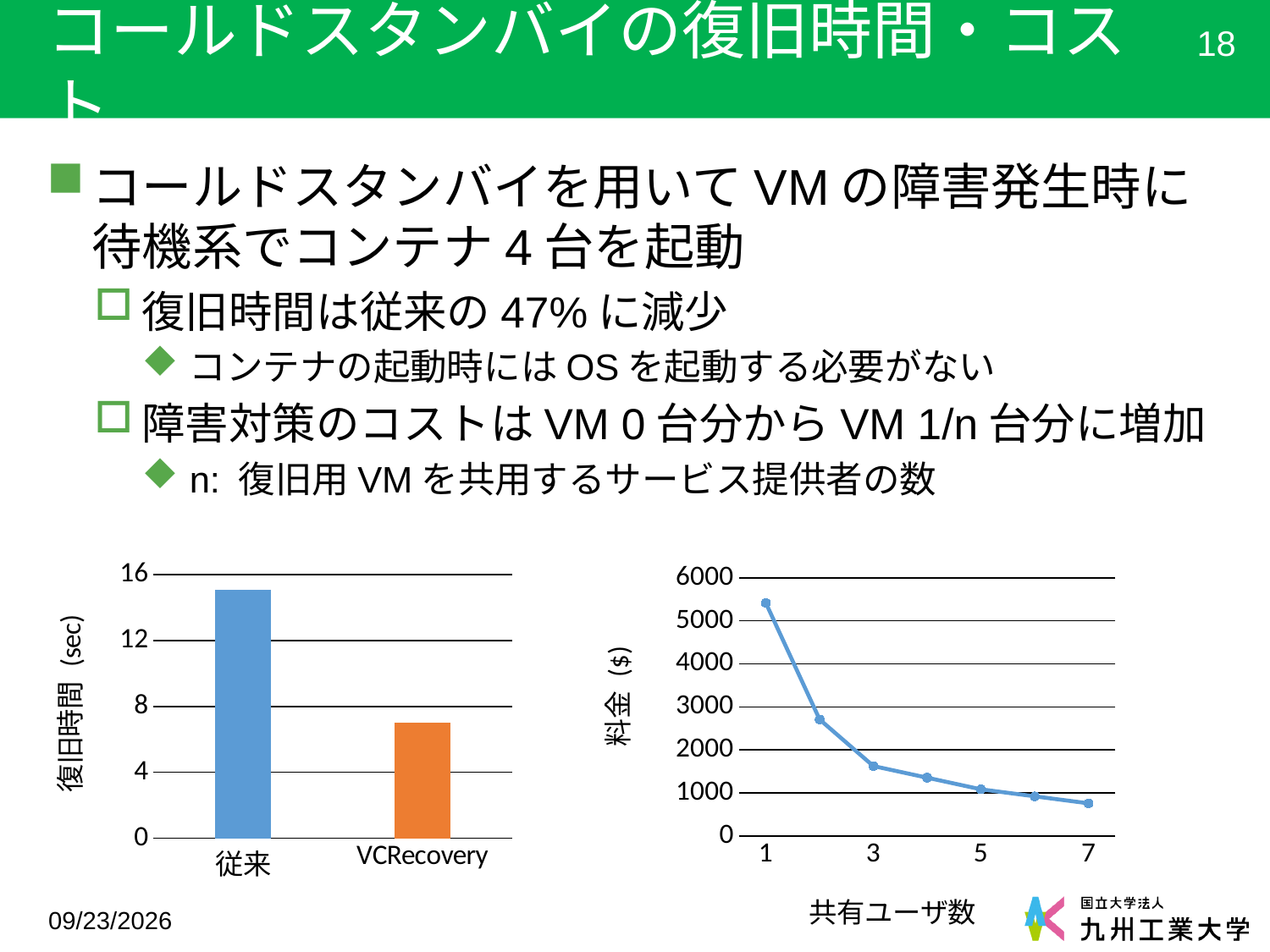
What kind of chart is the left chart showing 復旧時間 (sec)? bar chart In the right chart, is the value at 共有ユーザ数 = 7 greater or less than 1000? less In the right chart, does 料金 rise or fall as 共有ユーザ数 increases? fall In the left chart, which category has the higher 復旧時間, 従来 or VCRecovery? 従来 In the right chart, how many data points are plotted on the line? 7 What kind of chart is the right chart showing 料金 ($)? line chart In the left chart, is the value for 従来 greater or less than 12? greater In the left chart, how many bars are plotted? 2 In the right chart, is the value at 共有ユーザ数 = 1 greater or less than 5000? greater What is the x-axis title of the right chart? 共有ユーザ数 In the left chart, which category has the lowest 復旧時間? VCRecovery